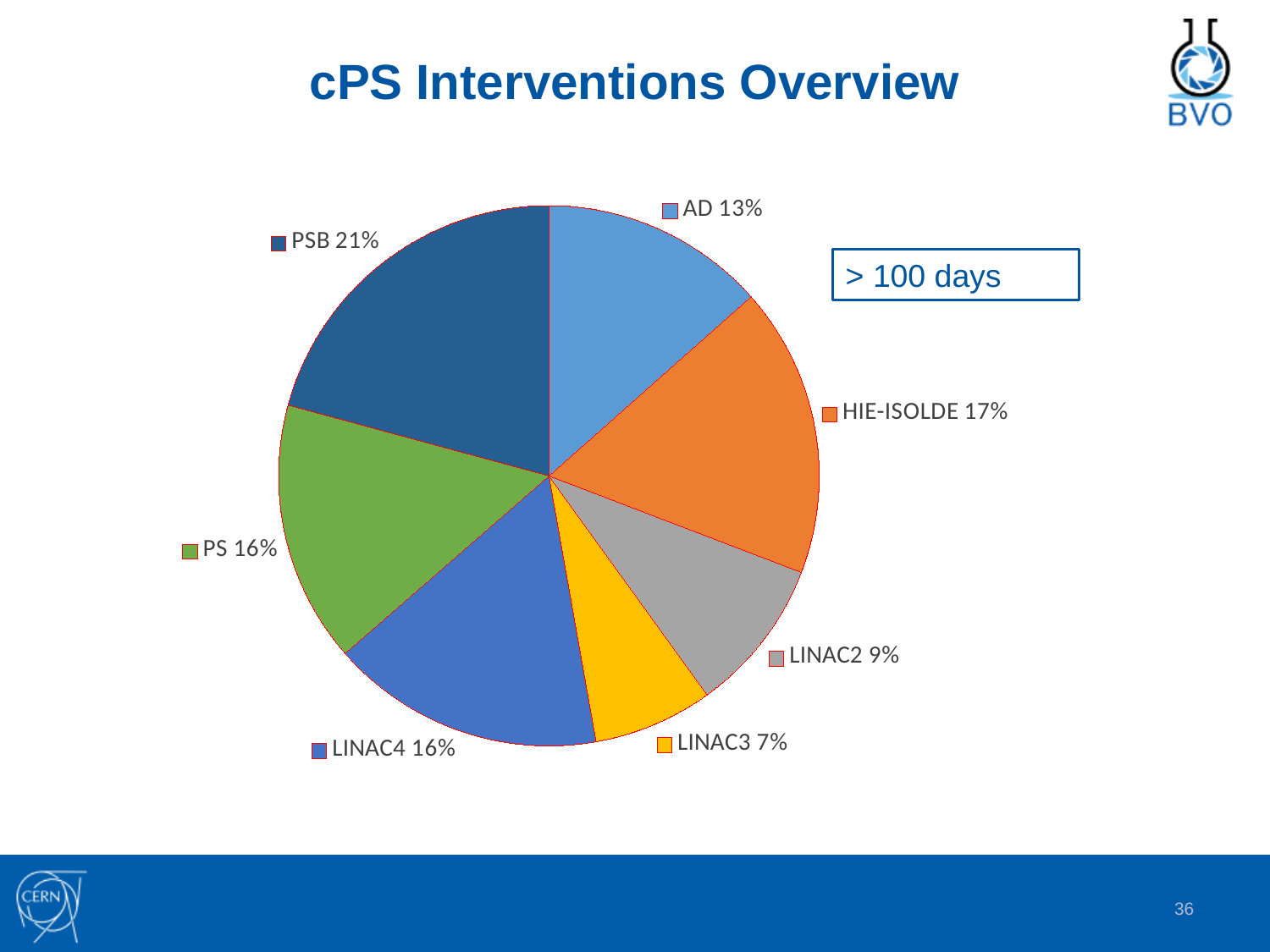
What is the difference between the PSB share and the AD share? 8% Which category has the largest slice of the pie? PSB What is the value shown for HIE-ISOLDE? 17% Which is larger, the share for LINAC2 or the share for AD? AD What share of the pie does PSB account for? 21% Which category has the smallest slice of the pie? LINAC3 What is the title of the slide containing the chart? cPS Interventions Overview What is the value shown for LINAC3? 7% What colour is the PS slice of the pie? green What kind of chart is shown on the slide? pie chart What is the value shown for LINAC4? 16% How many slices does the pie chart have? 7